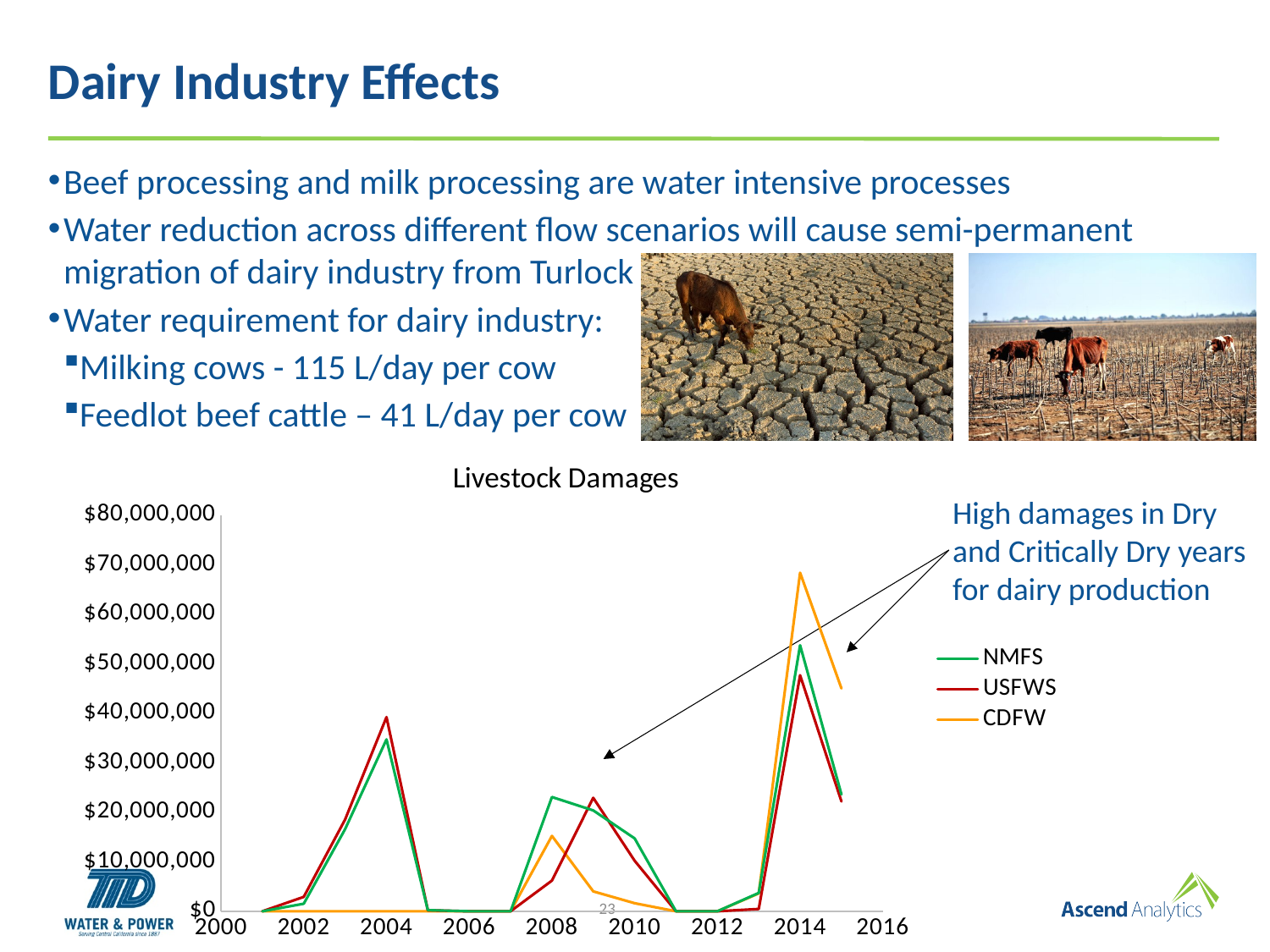
In the Livestock Damages chart, is the USFWS value for 2004 greater or less than $30,000,000? greater What is the title of the chart on the slide? Livestock Damages In the Livestock Damages chart, is the NMFS value for 2004 greater or less than $40,000,000? less In the Livestock Damages chart, do the values for all three series rise or fall from 2012 to 2014? rise What kind of chart is the Livestock Damages chart? line chart In the Livestock Damages chart, which is larger in 2008, the NMFS value or the USFWS value? NMFS How many series does the legend of the Livestock Damages chart list? 3 In the Livestock Damages chart, is the CDFW value for 2008 greater or less than $10,000,000? greater What are the series names in the legend of the Livestock Damages chart? NMFS, USFWS, CDFW In the Livestock Damages chart, which series has the highest value in 2014? CDFW In the Livestock Damages chart, which is larger in 2004, the USFWS value or the NMFS value? USFWS